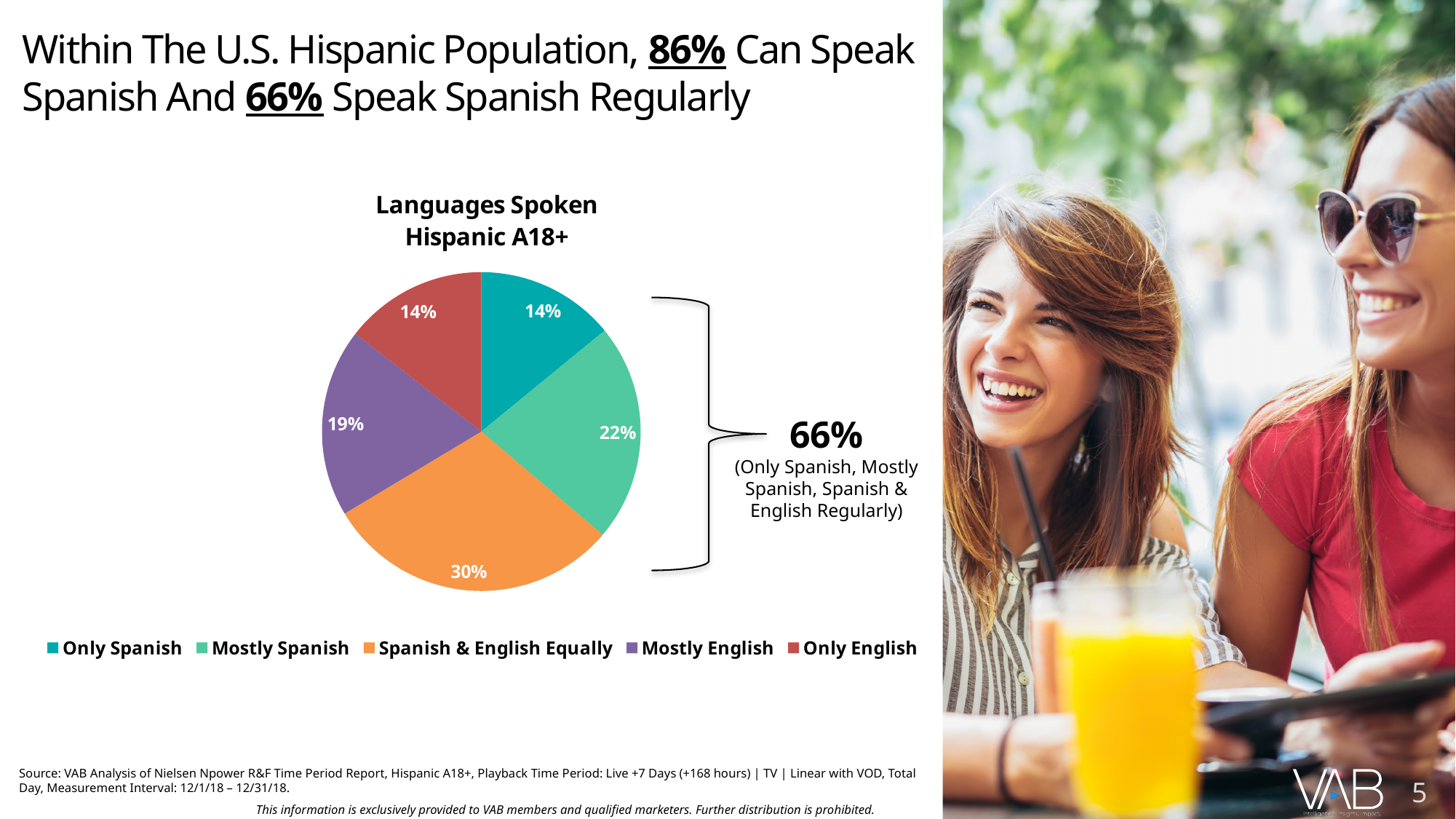
How many categories does the legend list? 5 What share of the pie is Spanish & English Equally? 30% What is the value for Mostly Spanish? 22% Which is larger, Mostly English or Only Spanish? Mostly English What is the difference between the Spanish & English Equally slice and the Mostly Spanish slice? 8% What type of chart is shown on the slide? Pie chart What is the value for Only English? 14% What colour is the Spanish & English Equally slice? Orange Which category has the largest slice of the pie? Spanish & English Equally What is the combined share of Only Spanish, Mostly Spanish and Spanish & English Equally, as labelled by the bracket? 66% What is the title of the chart? Languages Spoken Hispanic A18+ What is the value for Mostly English? 19%